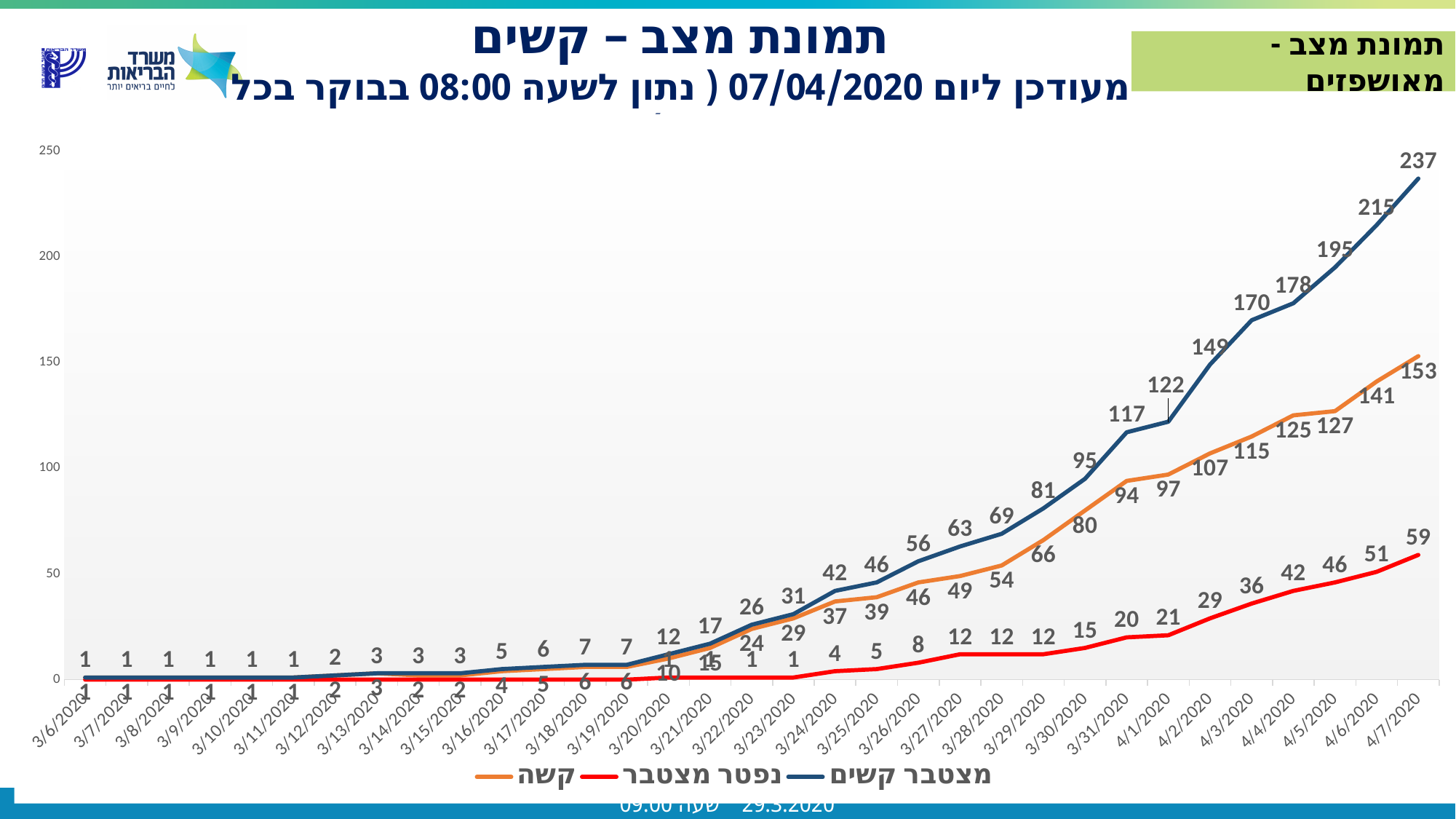
What is the value of the נפטר מצטבר series on 3/31/2020? 20 What is the value of the מצטבר קשים series on 4/7/2020? 237 On 4/1/2020, which series has the larger value: מצטבר קשים or קשה? מצטבר קשים By how much did the מצטבר קשים series increase from 4/6/2020 to 4/7/2020? 22 What kind of chart is shown on the slide? Line chart On which date does the מצטבר קשים series reach its highest value? 4/7/2020 What is the value of the נפטר מצטבר series on 4/7/2020? 59 What is the difference between the מצטבר קשים value and the קשה value on 4/7/2020? 84 How many series does the legend list? 3 Does the מצטבר קשים series rise or fall from 3/6/2020 to 4/7/2020? Rise What is the value of the קשה series on 4/7/2020? 153 What is the value of the מצטבר קשים series on 3/25/2020? 46